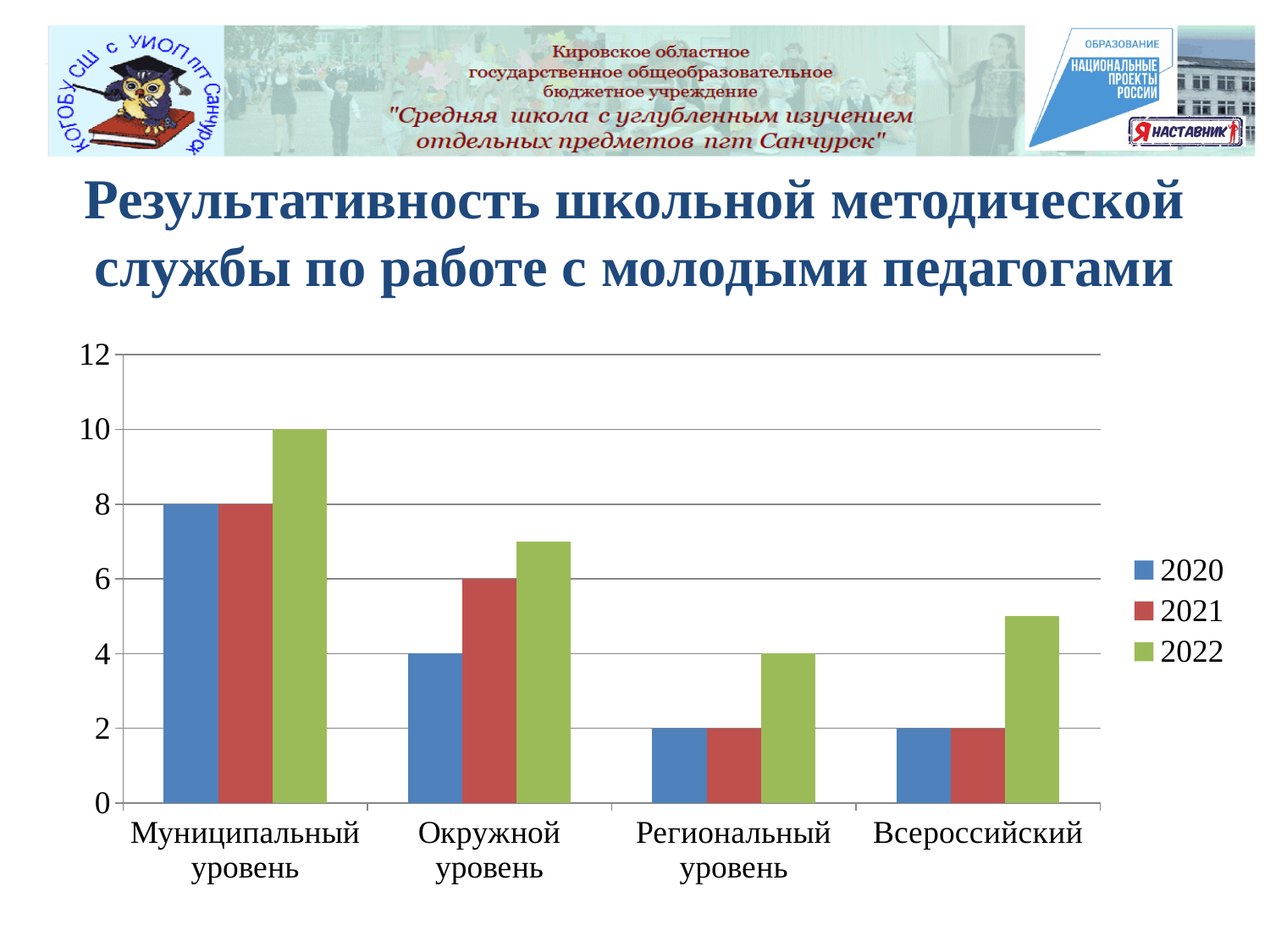
What is the value for 2021 at Окружной уровень? 6 What kind of chart is shown on the slide? bar chart What is the value for 2020 at Окружной уровень? 4 Is the value for 2022 at Всероссийский greater or less than 4? greater What is the difference between the 2022 and 2020 values at Муниципальный уровень? 2 How many categories are shown on the x axis? 4 What is the value for 2020 at Муниципальный уровень? 8 How many series does the legend list? 3 What is the value for 2022 at Региональный уровень? 4 What is the value for 2022 at Муниципальный уровень? 10 Which is larger at Окружной уровень: the value for 2020 or the value for 2021? 2021 Which category has the highest value for 2022? Муниципальный уровень